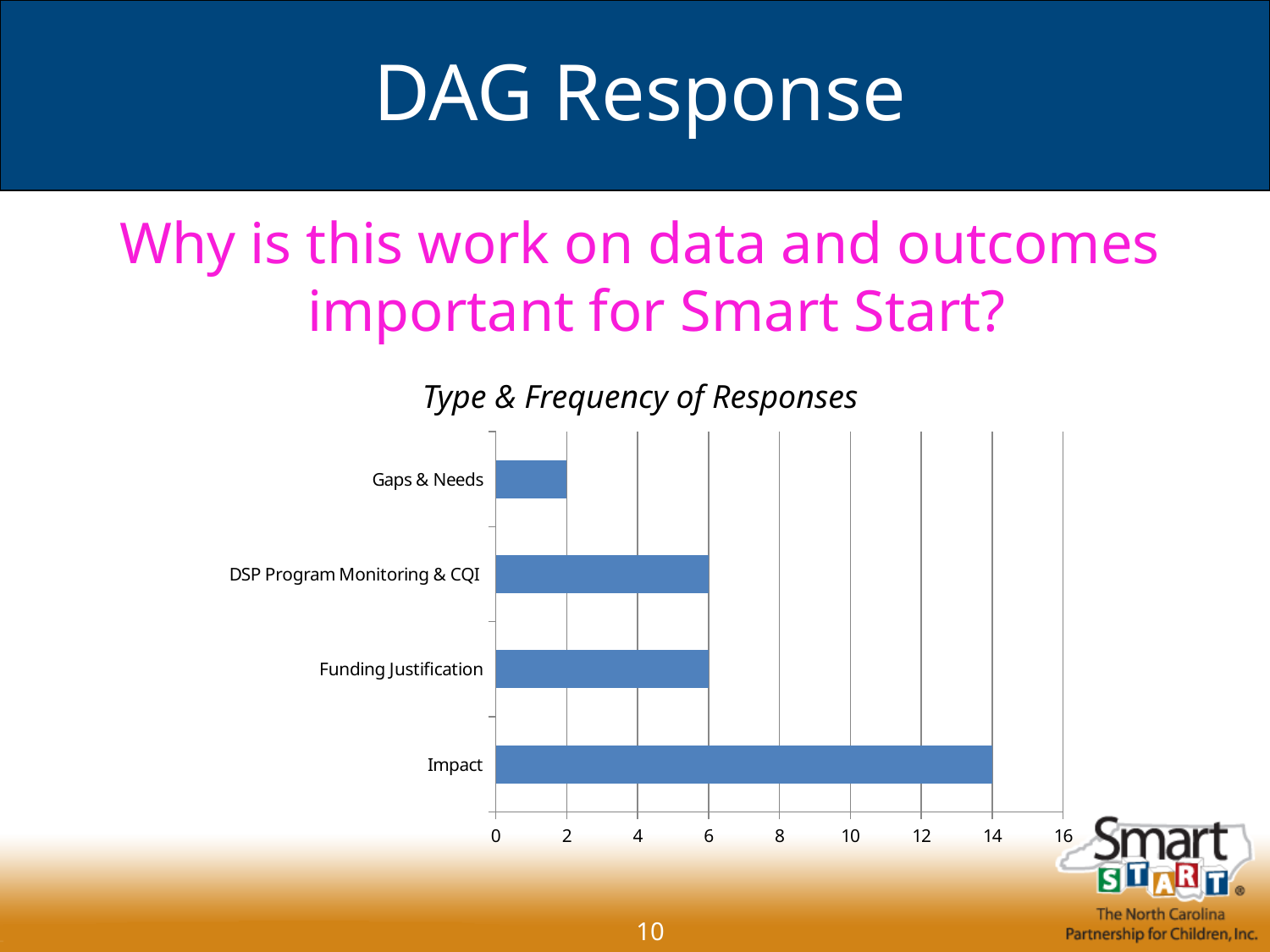
What is the difference between the values for Impact and Gaps & Needs? 12 What kind of chart is shown on the slide? Bar chart Which category has the lowest value? Gaps & Needs What is the value for DSP Program Monitoring & CQI? 6 Is the value for Impact greater or less than 10? greater What is the value for Gaps & Needs? 2 Which is larger, the value for Impact or the value for Funding Justification? Impact How many categories are shown in the chart? 4 Which category has the highest value? Impact What is the title of the chart? Type & Frequency of Responses What is the value for Impact? 14 What is the value for Funding Justification? 6